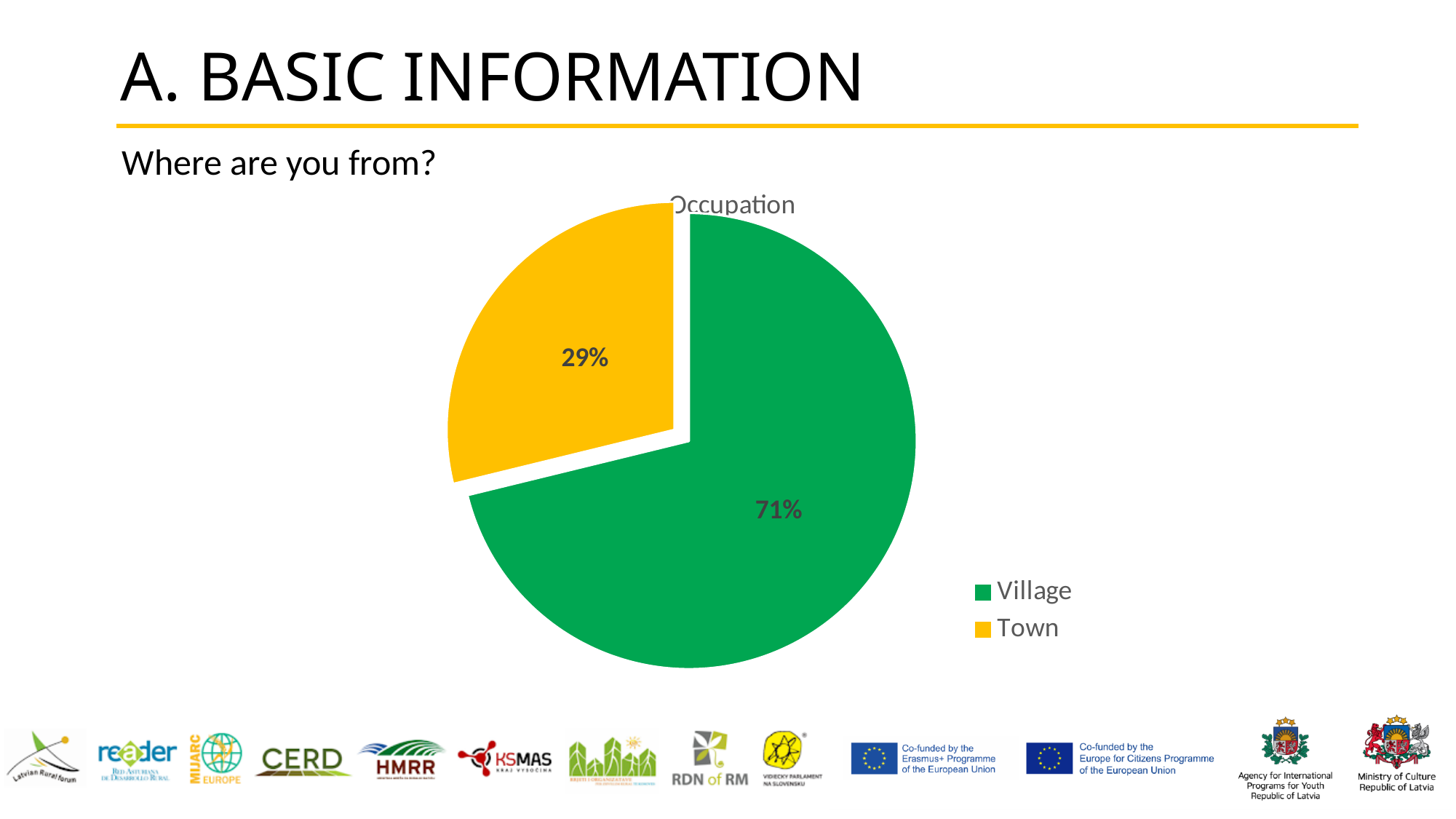
What kind of chart is shown on the slide? Pie chart What colour is the Town slice of the pie? Yellow What is the title printed above the pie chart? Occupation What percentage of respondents are from a village? 71% What percentage of respondents are from a town? 29% How many entries does the legend list? 2 How many categories does the pie chart show? 2 Which is larger, the share for Village or the share for Town? Village Which category has the smallest share of the pie? Town Which category has the largest share of the pie? Village What is the difference in percentage points between the Village and Town shares? 42